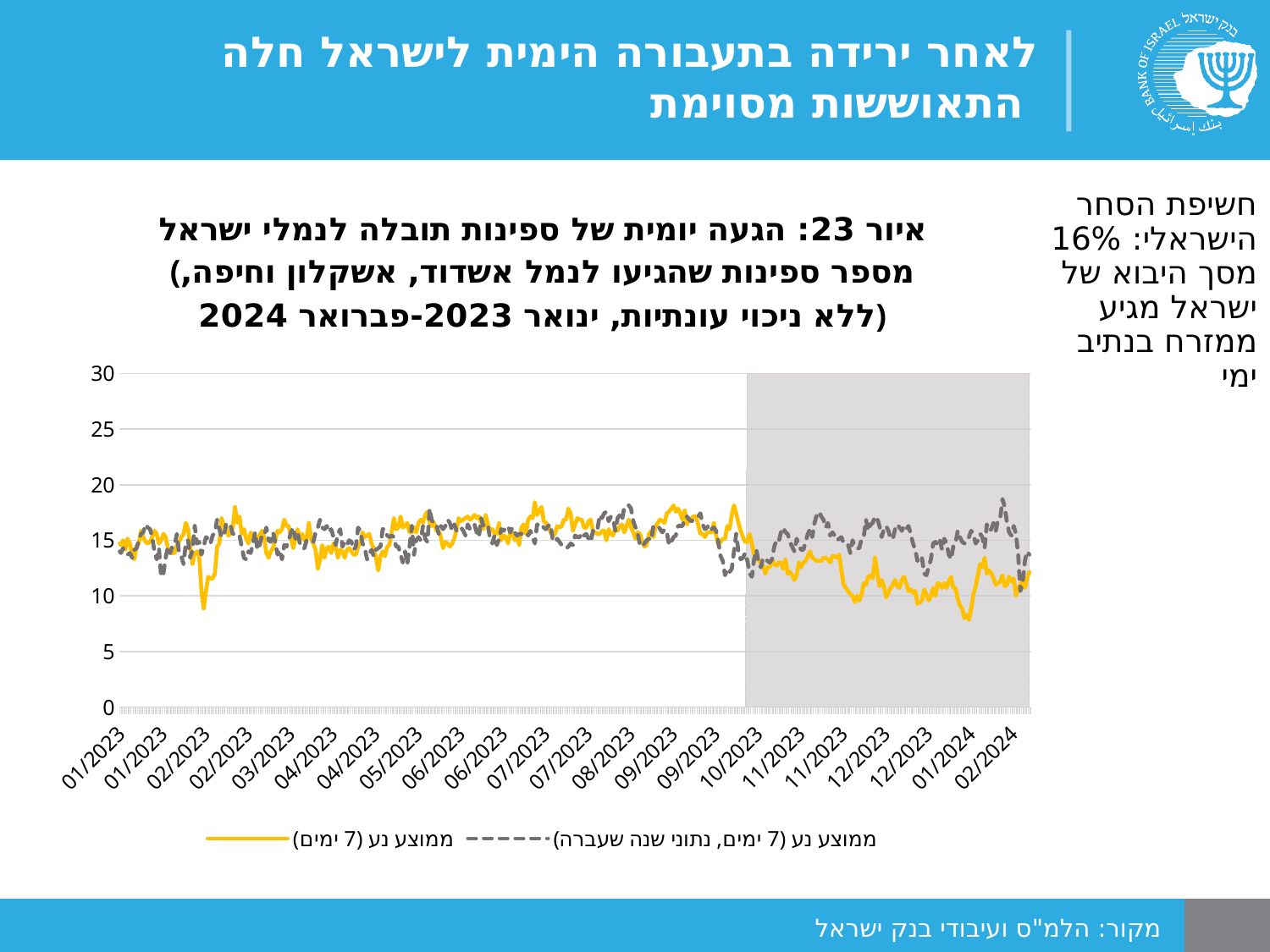
What kind of chart is shown on the slide? line chart Is the highest value reached by either series greater or less than 20? less How many tick labels are shown on the y axis? 7 How many series does the chart legend list? 2 What is the highest value shown on the y axis? 30 At which x-axis date does the grey shaded region of the chart begin? 10/2023 Which legend entry is drawn as a dashed grey line? ממוצע נע (7 ימים, נתוני שנה שעברה) In the shaded period from 10/2023 onward, which series is generally higher: the yellow solid line or the grey dashed line? the grey dashed line (ממוצע נע (7 ימים, נתוני שנה שעברה)) Is the value of the yellow series (ממוצע נע (7 ימים)) at the start of 01/2023 greater or less than 10? greater Does the yellow series (ממוצע נע (7 ימים)) generally rise or fall after 10/2023 compared with the earlier months of 2023? fall What is the figure number given in the chart title? איור 23 Is the lowest value reached by the yellow series (ממוצע נע (7 ימים)) greater or less than 10? less